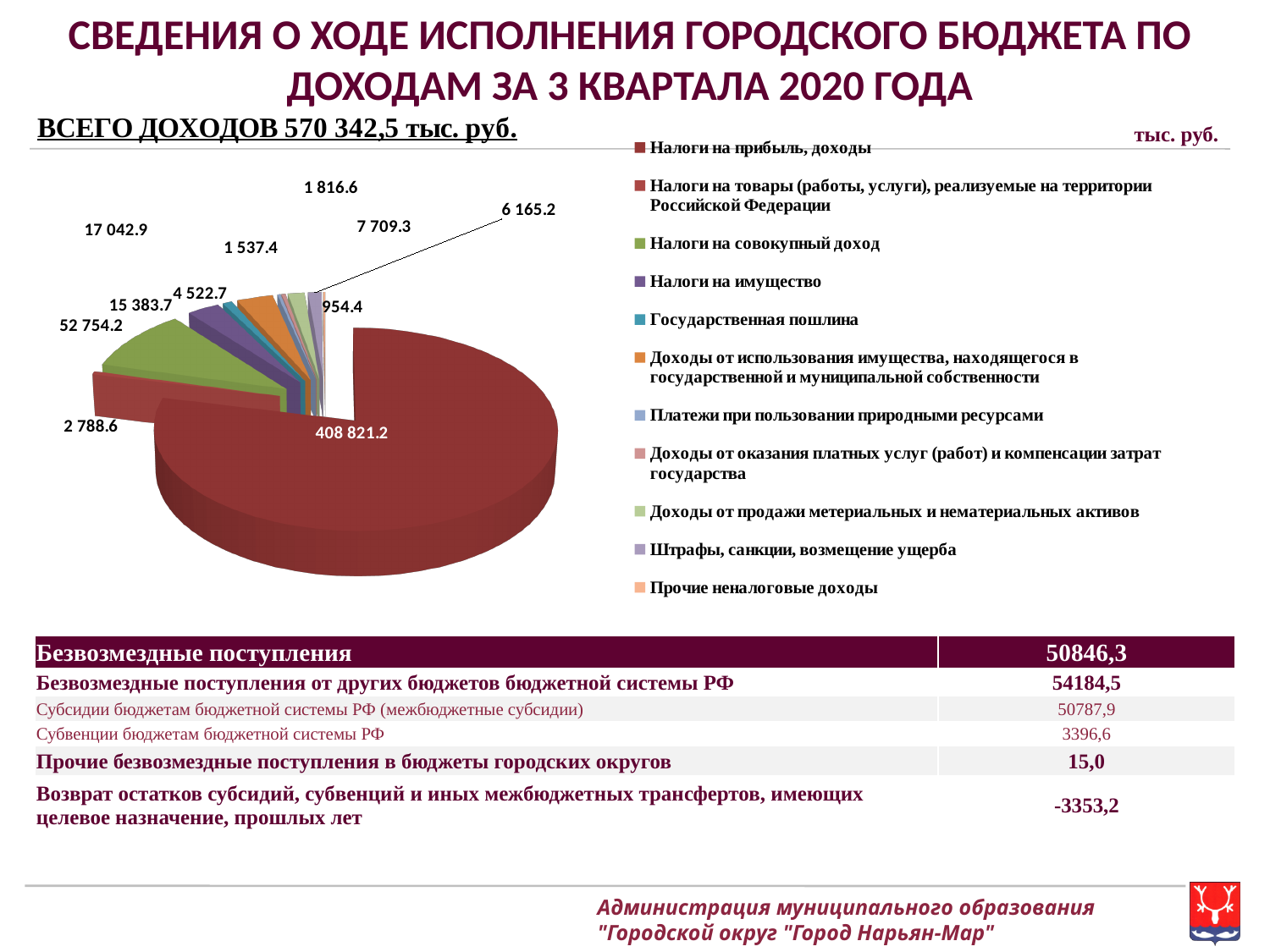
Which is larger in the pie chart: the slice labelled 52 754.2 or the slice labelled 17 042.9? 52 754.2 What is the value of the orange slice (Доходы от использования имущества, находящегося в государственной и муниципальной собственности)? 17 042.9 What is the difference between the slices labelled 52 754.2 and 17 042.9? 35 711.3 In what units are the pie chart values given, according to the label at the top right of the chart? тыс. руб. What is the value of the largest slice in the pie chart? 408 821.2 How many entries does the pie chart's legend list? 11 What is the smallest value labelled on the pie chart? 954.4 Which legend category does the largest slice of the pie chart (408 821.2) correspond to? Налоги на прибыль, доходы What is the difference between the slices labelled 17 042.9 and 15 383.7? 1 659.2 What is the value of the green slice (Налоги на совокупный доход) in the pie chart? 52 754.2 What kind of chart is shown on the slide? pie chart What total income is stated above the pie chart? 570 342,5 тыс. руб.